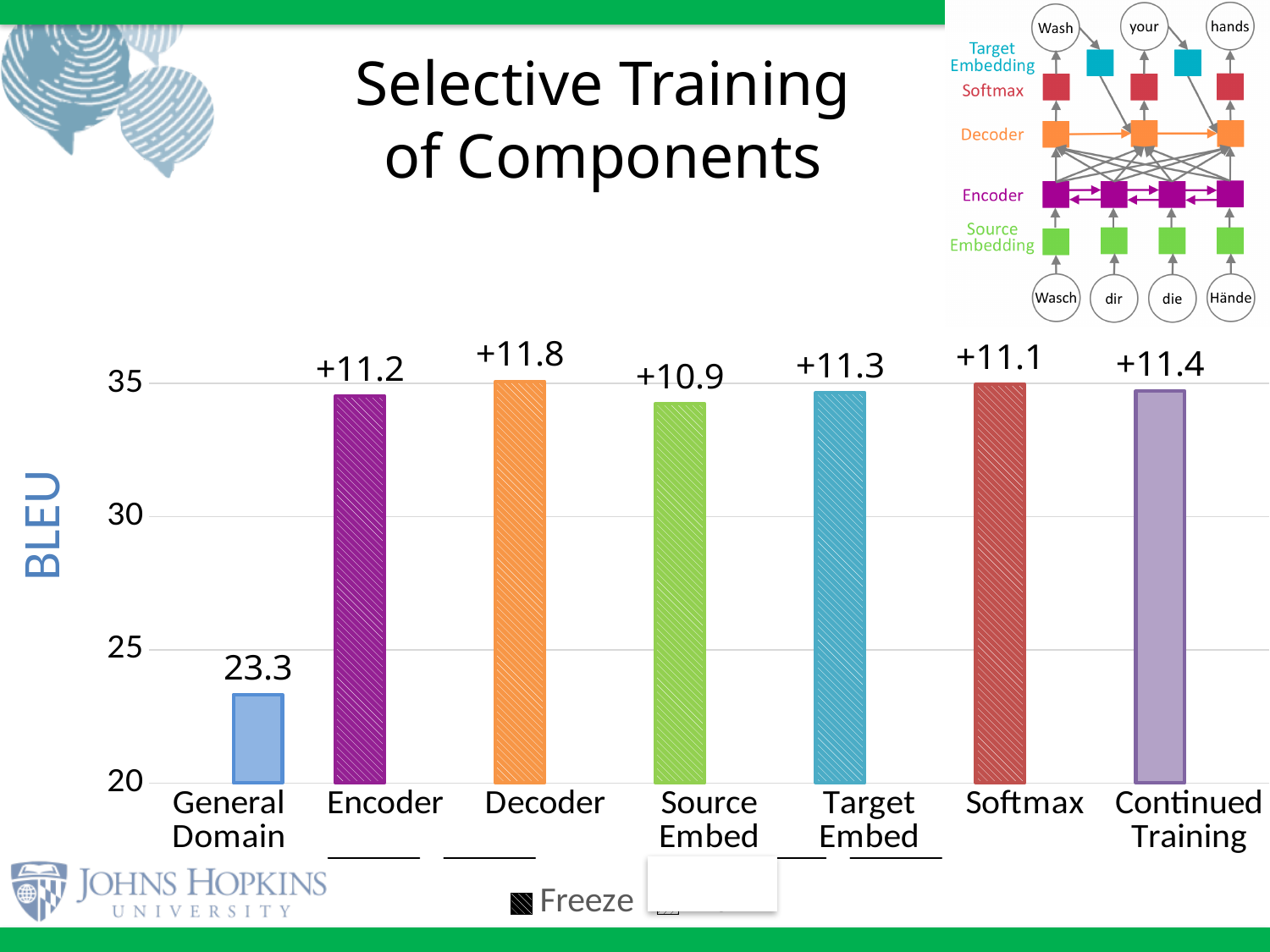
What kind of chart is shown on the slide? bar chart What data label is shown above the Source Embed bar? +10.9 Which bar has the larger labelled improvement, Encoder or Decoder? Decoder What is the label on the vertical axis of the chart? BLEU How many bars are shown in the chart? 7 What data label is shown above the General Domain bar? 23.3 Which category has the shortest bar in the chart? General Domain What data label is shown above the Continued Training bar? +11.4 What data label is shown above the Decoder bar? +11.8 Which category has the tallest bar in the chart? Decoder Is the BLEU value for General Domain greater or less than 25? less What is the difference between the labelled improvements for Decoder (+11.8) and Source Embed (+10.9)? 0.9